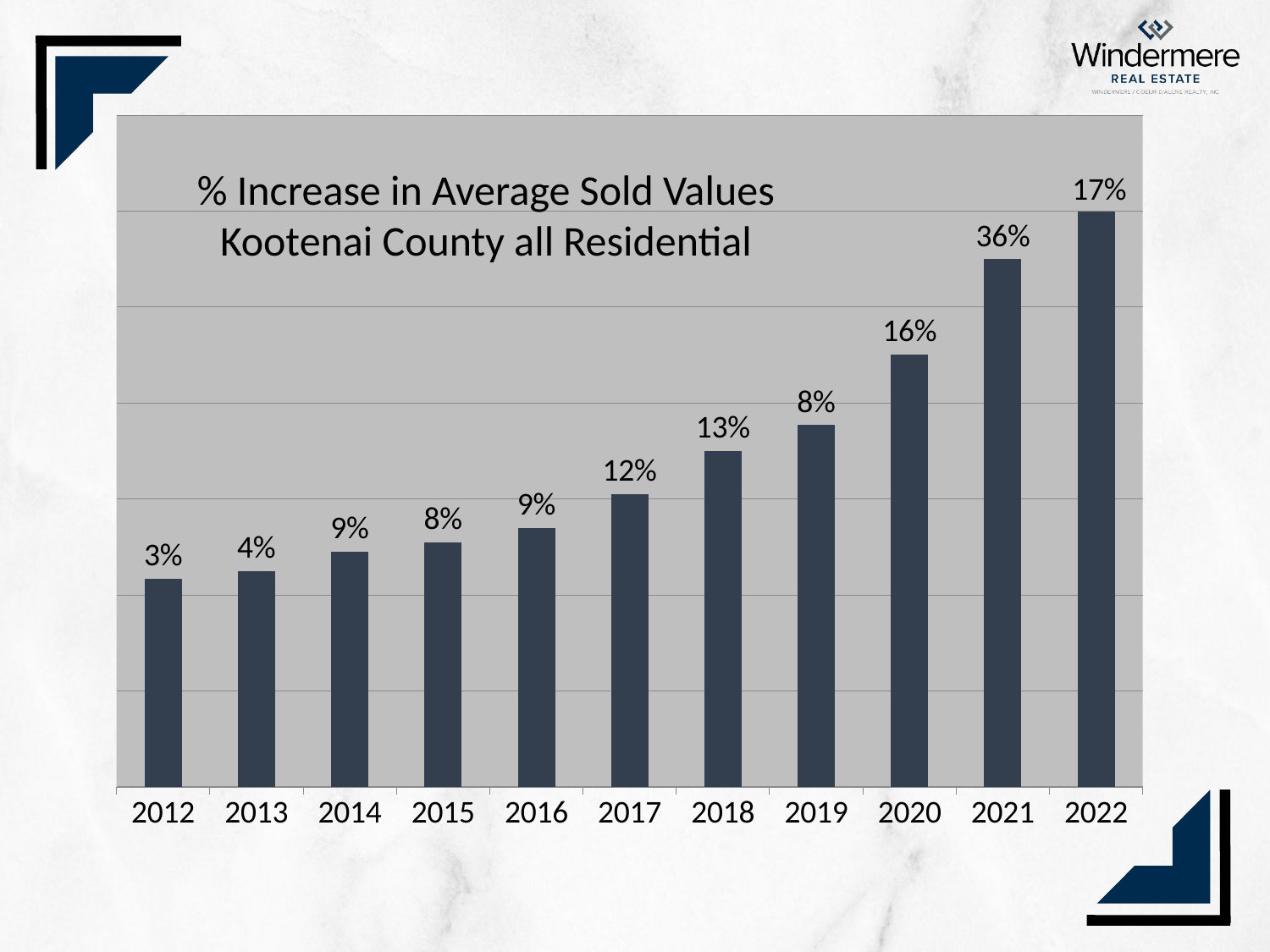
What is the difference between the labelled values for 2020 and 2012? 13 percentage points What is the title of the chart? % Increase in Average Sold Values Kootenai County all Residential Which is larger, the value for 2020 or the value for 2012? 2020 What value is labelled for 2020? 16% What value is labelled for 2017? 12% Which year has the lowest value on the chart? 2012 What kind of chart is shown on the slide? Bar chart What is the % increase in average sold values shown for 2012? 3% How many years are shown on the x axis? 11 Do the bars generally rise or fall from 2012 to 2022? Rise What value is labelled for 2021? 36% What value is labelled for 2014? 9%